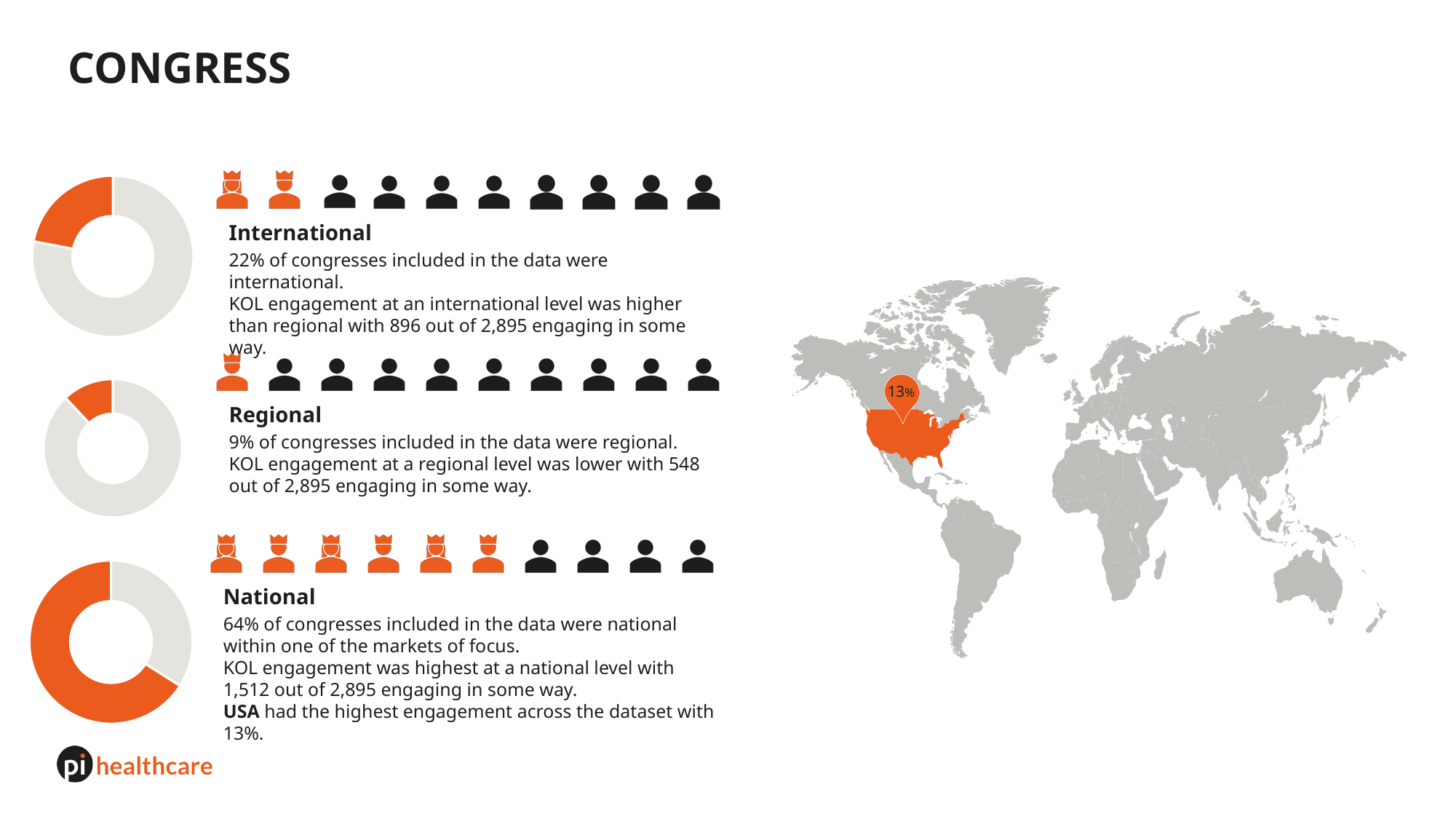
What is the difference in percentage points between the National share and the International share shown in the donut charts? 42 How many donut charts are shown on the slide? 3 Which is larger, the International share or the Regional share of congresses? International Across the three donut charts, which congress level has the largest share? National On the world map, what engagement percentage is labelled for the USA? 13% What kind of chart is used on the left side of the slide to show the share of congresses at each level? Donut (pie) chart In the National pictogram row, how many of the ten person icons are highlighted in orange? 6 What share of congresses does the middle donut chart (Regional) represent? 9% How many KOLs engaged at a national level out of 2,895? 1,512 Across the three donut charts, which congress level has the smallest share? Regional What share of congresses does the bottom donut chart (National) represent? 64% What share of congresses does the top donut chart (International) represent? 22%